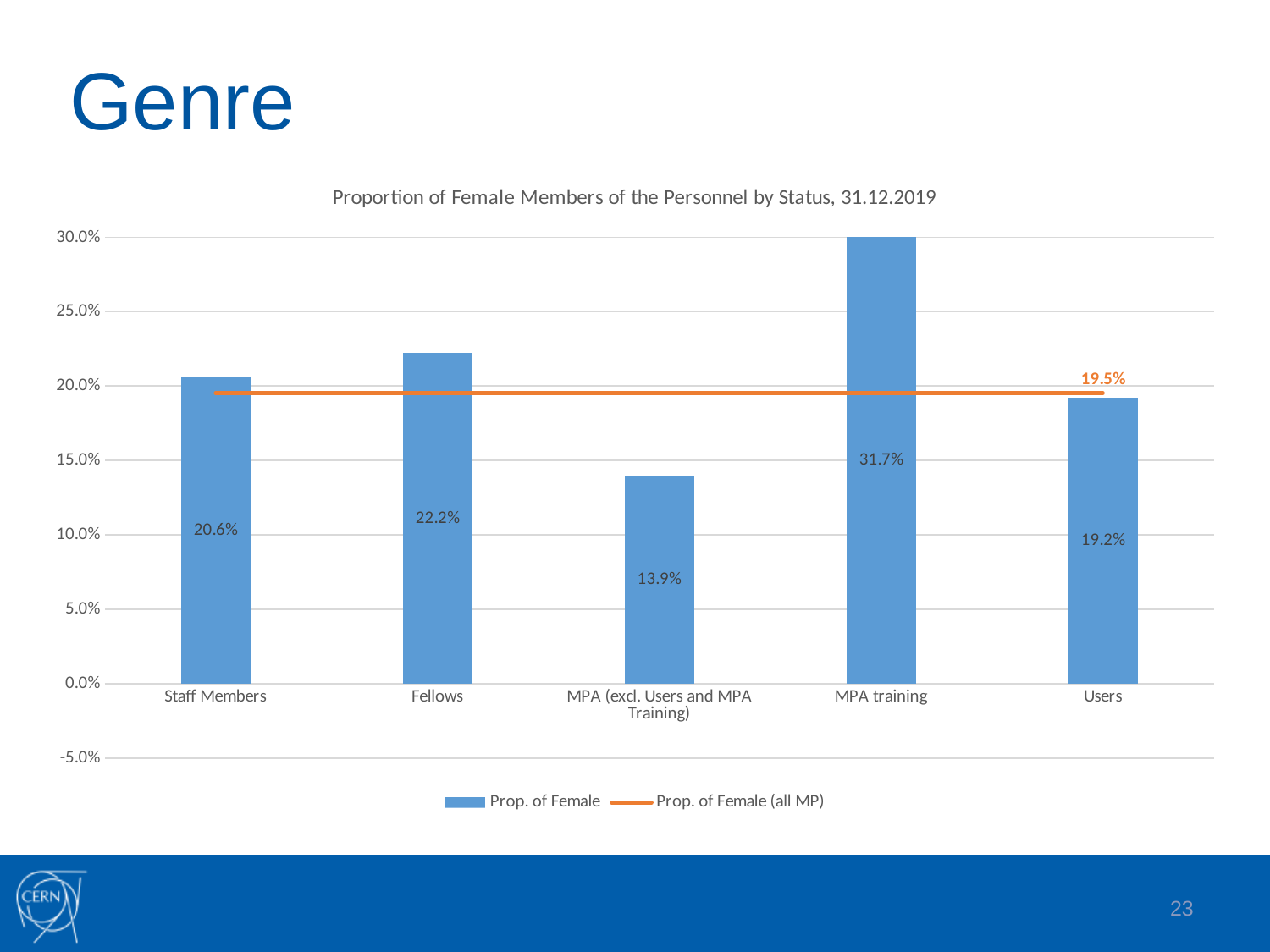
Which status has the highest proportion of female members? MPA training What is the difference between the proportion of female MPA training personnel and female Users? 12.5% How many series does the legend list? 2 What is the proportion of female Staff Members? 20.6% What is the proportion of female MPA training personnel? 31.7% Which status has the lowest proportion of female members? MPA (excl. Users and MPA Training) What is the proportion of female Users? 19.2% Which is larger, the proportion of female Fellows or female Staff Members? Fellows What is the proportion of female Fellows? 22.2% What is the title of the chart? Proportion of Female Members of the Personnel by Status, 31.12.2019 What is the value of the Prop. of Female (all MP) line? 19.5% How many status categories are shown on the x axis? 5